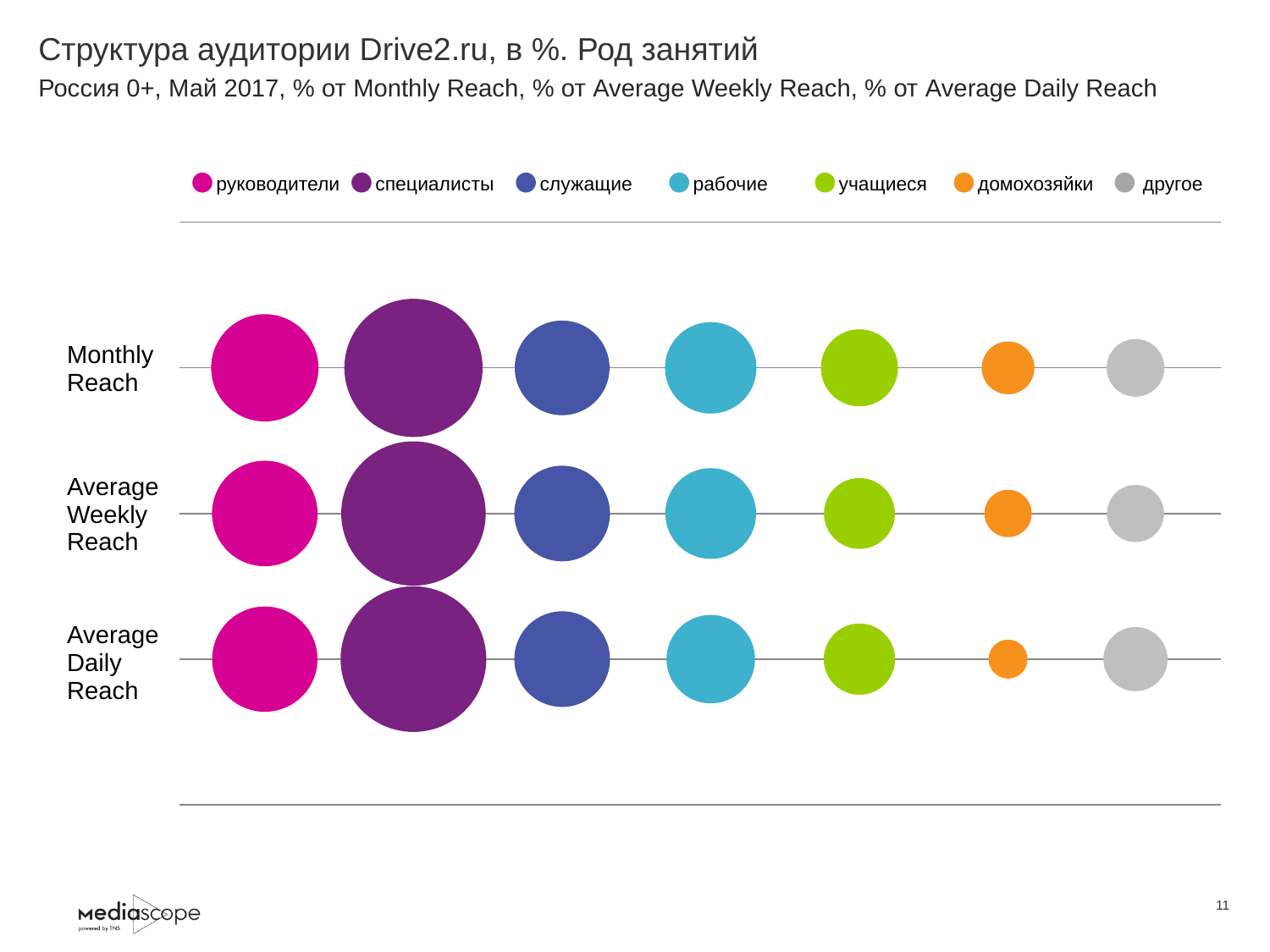
How many reach categories (rows) are plotted on the chart? 3 What kind of chart is shown on the slide? bubble chart In the Average Weekly Reach row, which bubble is larger: специалисты or рабочие? специалисты Which occupation group has the largest bubble in the Average Weekly Reach row? специалисты In the Average Daily Reach row, which bubble is larger: другое or домохозяйки? другое In the Monthly Reach row, which bubble is larger: руководители or служащие? руководители Which occupation group has the smallest bubble in the Average Daily Reach row? домохозяйки How many series does the legend list? 7 What is the first legend entry of the chart? руководители Which occupation group has the smallest bubble in the Monthly Reach row? домохозяйки What colour is used for the учащиеся series? green Which occupation group has the largest bubble in the Monthly Reach row? специалисты